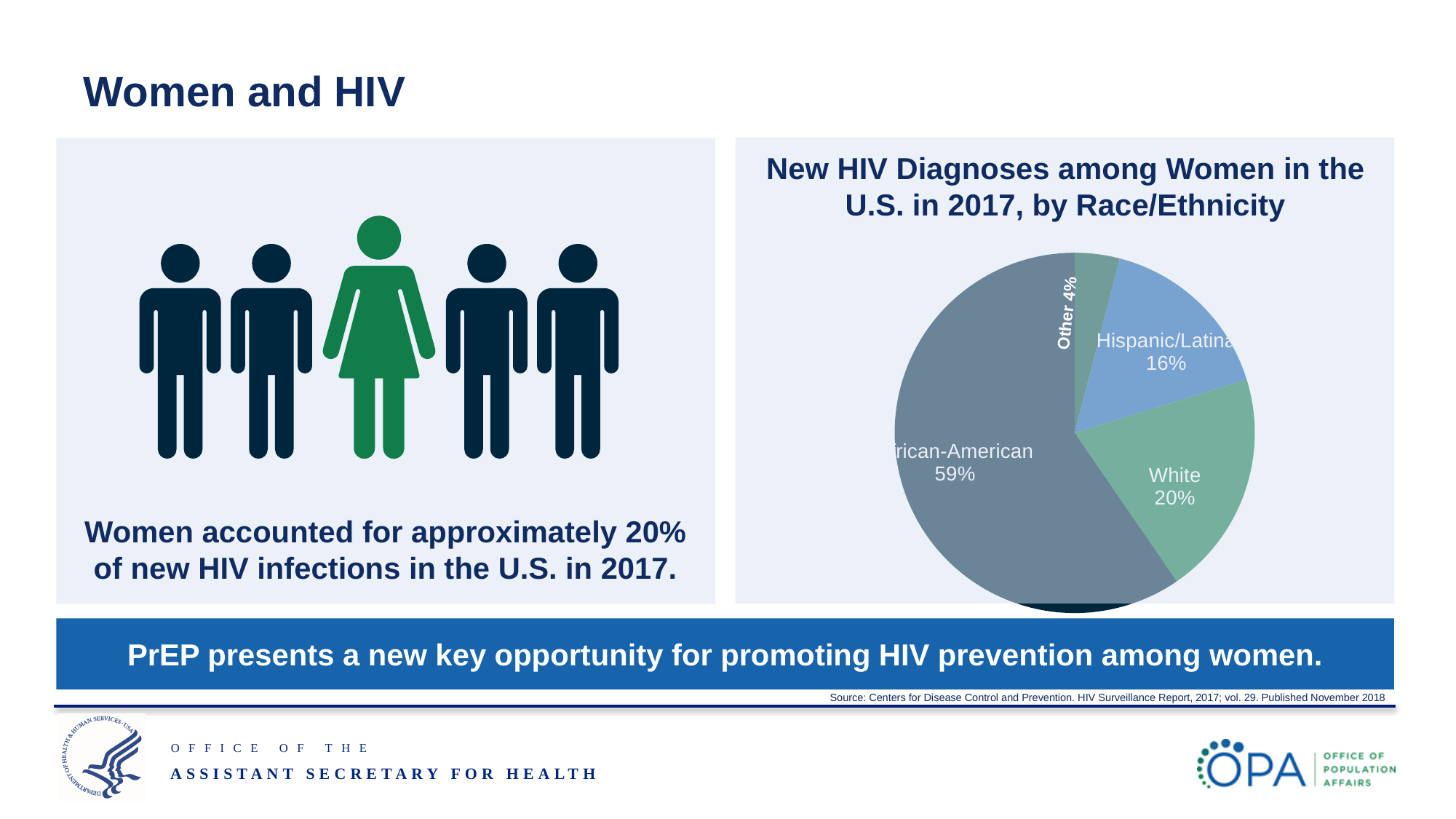
What share of new HIV diagnoses among women is White? 20% What is the title of the chart? New HIV Diagnoses among Women in the U.S. in 2017, by Race/Ethnicity Which slice is larger, White or Hispanic/Latina? White What kind of chart is shown on the slide? Pie chart What share of new HIV diagnoses among women is African-American? 59% Which race/ethnicity group has the largest slice of the pie? African-American How many slices does the pie chart have? 4 What share of new HIV diagnoses among women is Other? 4% What is the difference in percentage points between the Hispanic/Latina and Other slices? 12 What is the difference in percentage points between the African-American and White slices? 39 What share of new HIV diagnoses among women is Hispanic/Latina? 16% Which race/ethnicity group has the smallest slice of the pie? Other